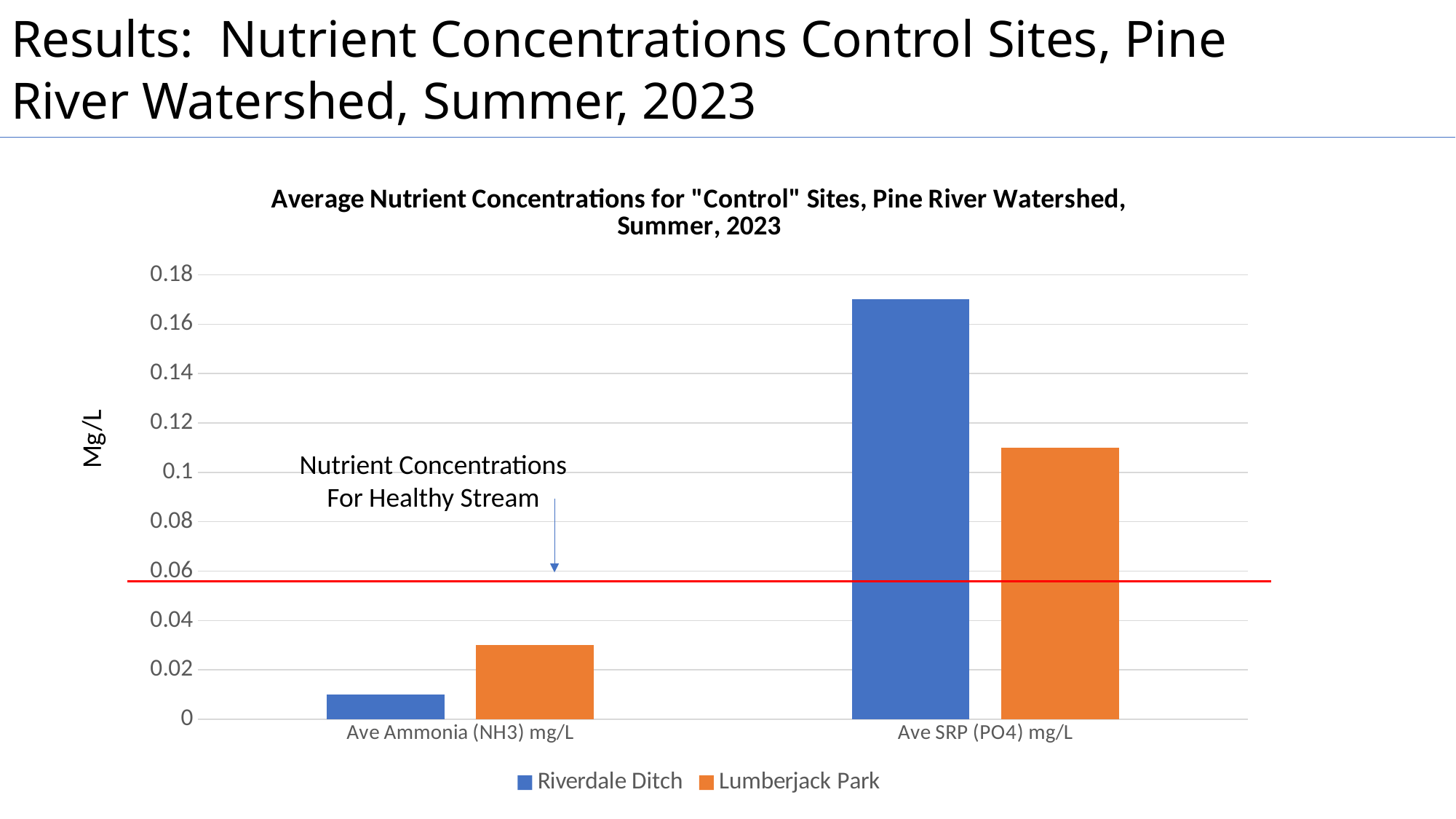
Is the Ave SRP (PO4) mg/L value for Riverdale Ditch greater or less than 0.16? greater What kind of chart is shown on the slide? bar chart Is the Ave SRP (PO4) mg/L value for Lumberjack Park greater or less than 0.12? less Which site has the higher Ave Ammonia (NH3) mg/L value, Riverdale Ditch or Lumberjack Park? Lumberjack Park Which bar is the shortest in the chart? Riverdale Ditch, Ave Ammonia (NH3) mg/L Which bar is the tallest in the chart? Riverdale Ditch, Ave SRP (PO4) mg/L How many series does the legend list? 2 Is the Ave Ammonia (NH3) mg/L value for Lumberjack Park greater or less than 0.04? less Which site has the higher Ave SRP (PO4) mg/L value, Riverdale Ditch or Lumberjack Park? Riverdale Ditch What label is shown on the y axis of the chart? Mg/L How many categories are shown on the x axis? 2